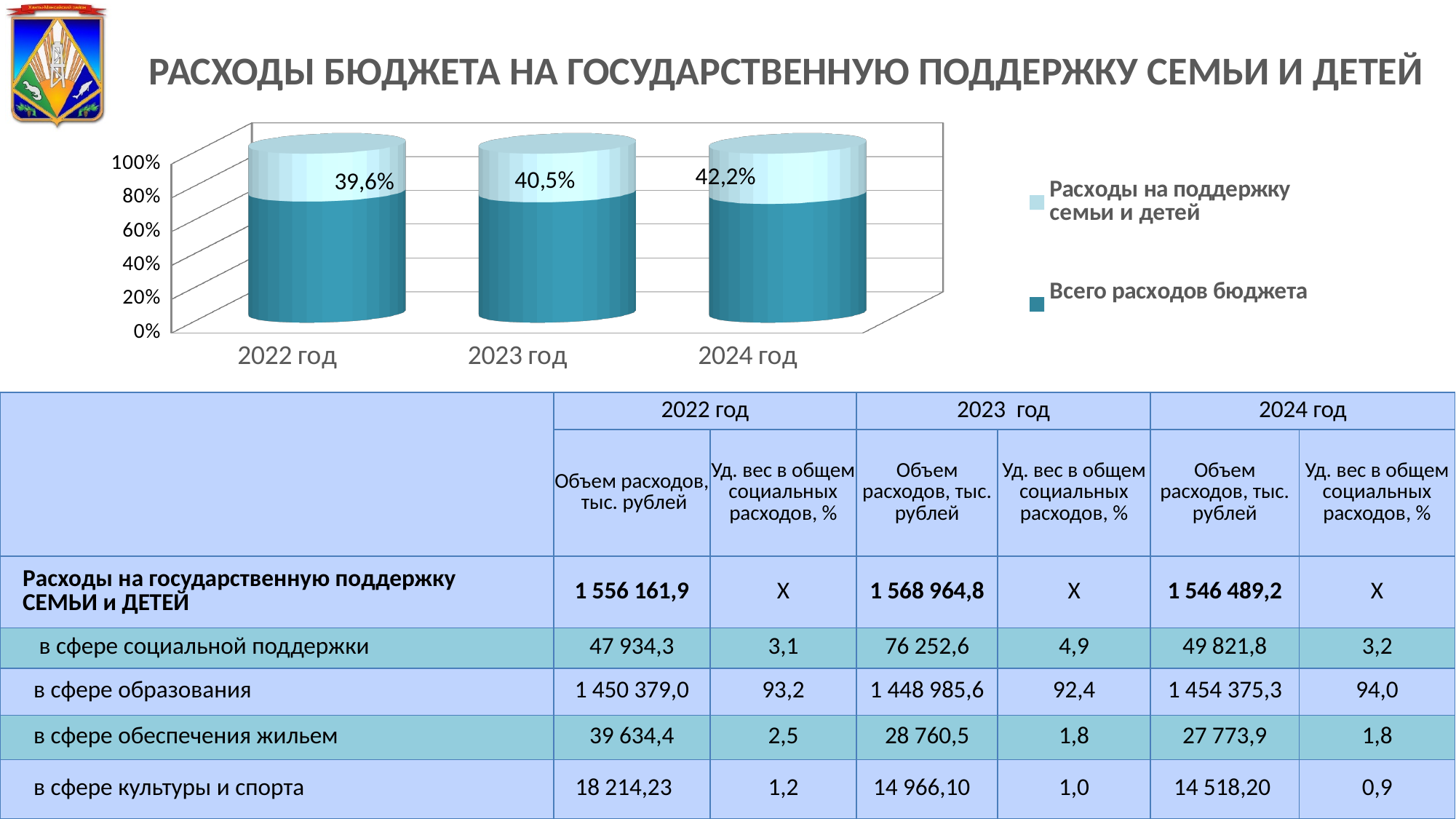
By how many percentage points does the labelled value for 2024 год exceed that for 2022 год? 2,6 What kind of chart is shown on the slide? Bar chart Which year has the lowest labelled percentage on the chart? 2022 год Do the labelled percentages rise or fall from 2022 год to 2024 год? Rise How many series does the chart legend list? 2 What is the data label shown on the bar for 2023 год? 40,5% Which year has the highest labelled percentage on the chart? 2024 год Which is larger, the labelled value for 2023 год or for 2022 год? 2023 год What is the data label shown on the bar for 2024 год? 42,2% How many years (categories) are shown on the x axis of the chart? 3 What is the data label shown on the bar for 2022 год? 39,6% Which legend entry is shown with the darker teal colour? Всего расходов бюджета